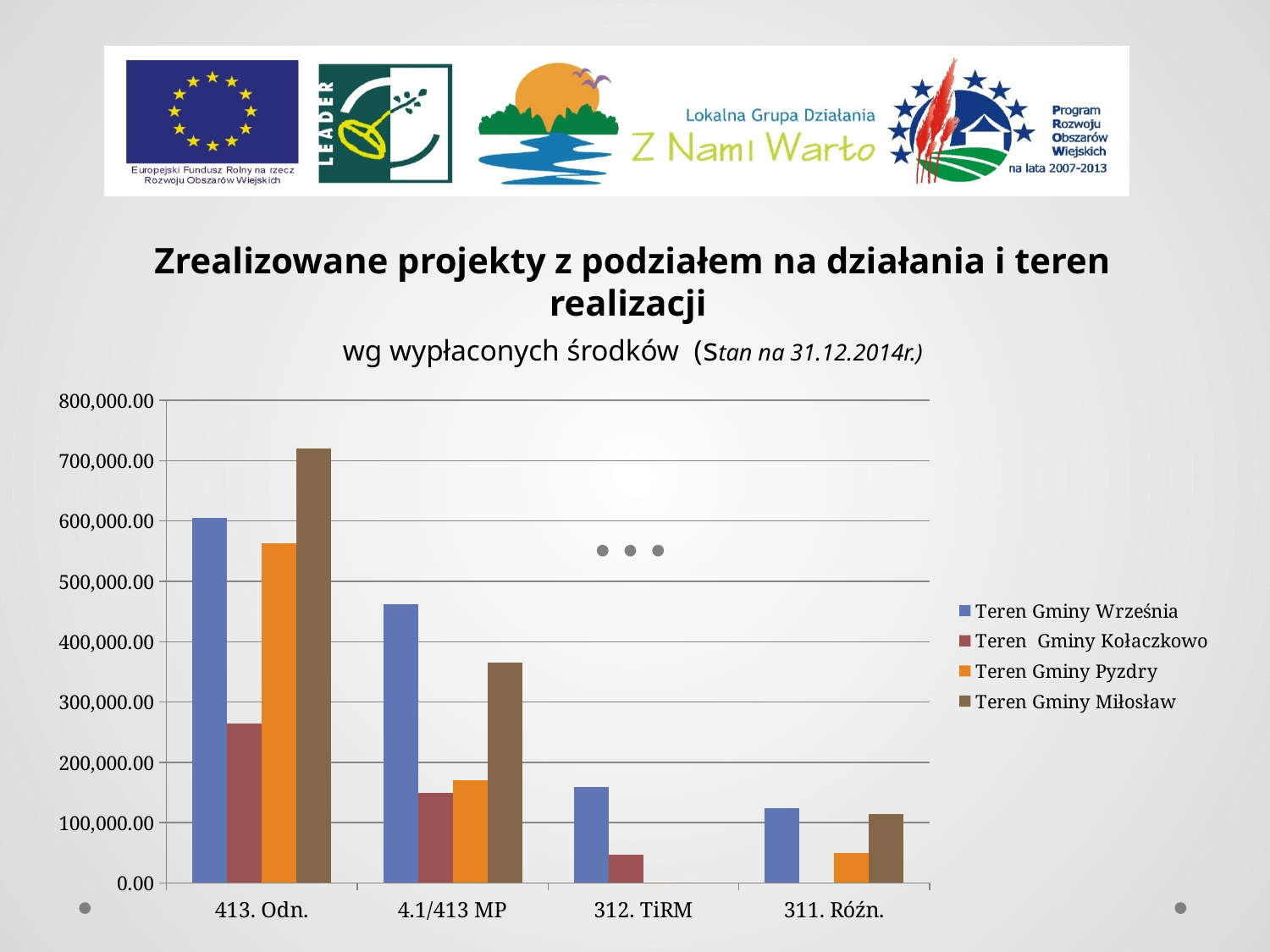
How many categories are shown on the x axis? 4 What colour represents Teren Gminy Miłosław in the legend? brown What kind of chart is shown on the slide? bar chart Is the value for Teren Gminy Miłosław in the 413. Odn. category greater or less than 700,000.00? greater Do the values for Teren Gminy Września rise or fall from 413. Odn. to 311. Różn.? fall In the 4.1/413 MP category, which is larger: Teren Gminy Września or Teren Gminy Miłosław? Teren Gminy Września Is the value for Teren Gminy Kołaczkowo in the 312. TiRM category greater or less than 100,000.00? less In the 413. Odn. category, which is larger: Teren Gminy Września or Teren Gminy Pyzdry? Teren Gminy Września Which series has the highest bar in the 413. Odn. category? Teren Gminy Miłosław In which category is the Teren Gminy Września bar lowest? 311. Różn. How many series does the legend list? 4 Is the value for Teren Gminy Września in the 4.1/413 MP category greater or less than 400,000.00? greater